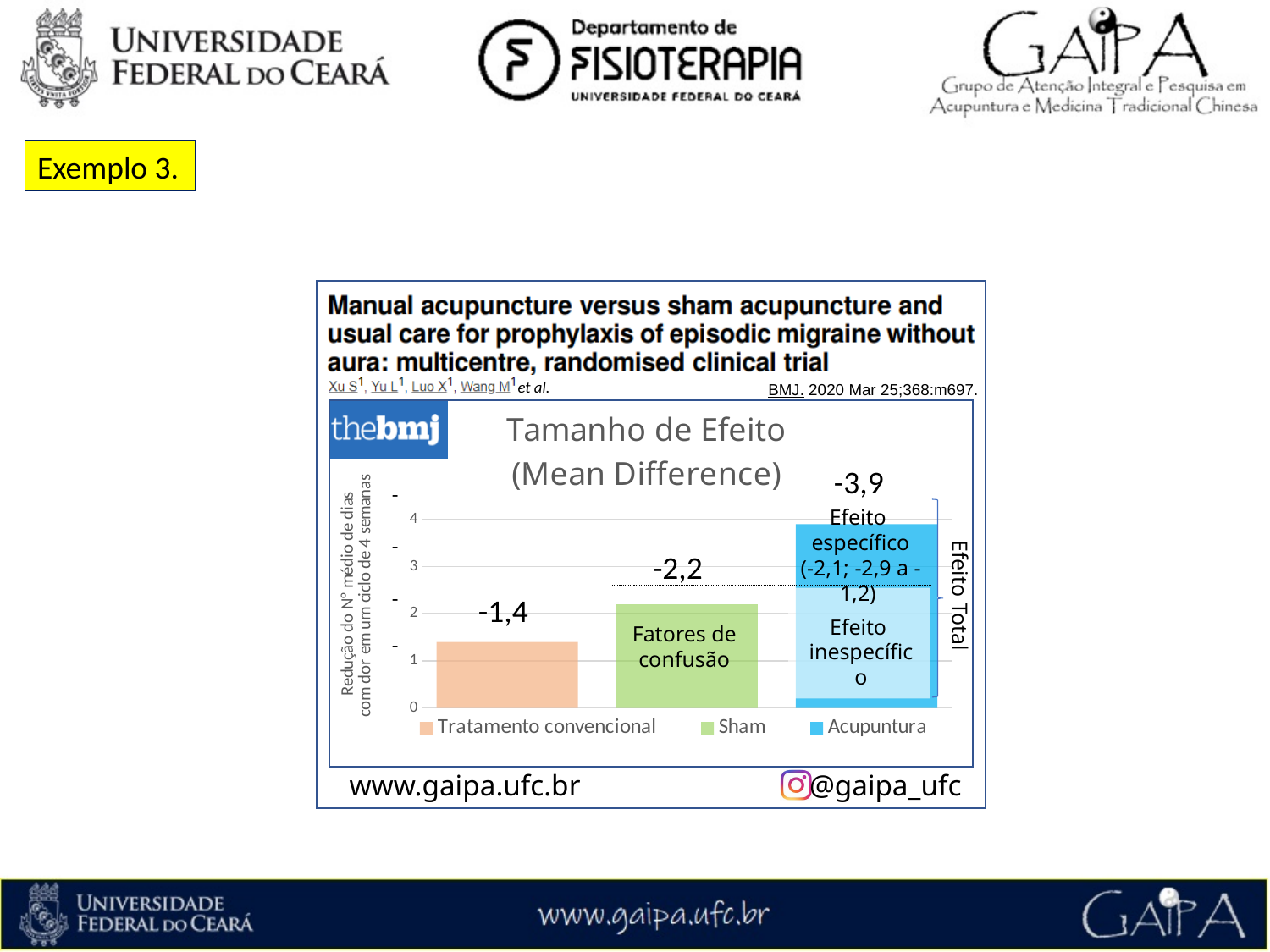
Which bar is taller, Sham or Tratamento convencional? Sham What kind of chart is shown? bar chart How many bars are plotted in the chart? 3 What is the data label shown for Sham? -2,2 How many series does the legend list? 3 What is the difference in magnitude between the Sham value (-2,2) and the Tratamento convencional value (-1,4)? 0,8 What is the data label shown for Tratamento convencional? -1,4 Is the height of the Acupuntura bar greater or less than 3 on the axis? greater Which category has the shortest bar? Tratamento convencional What is the data label shown for Acupuntura? -3,9 Which category has the tallest bar? Acupuntura What is the difference in magnitude between the Acupuntura value (-3,9) and the Tratamento convencional value (-1,4)? 2,5